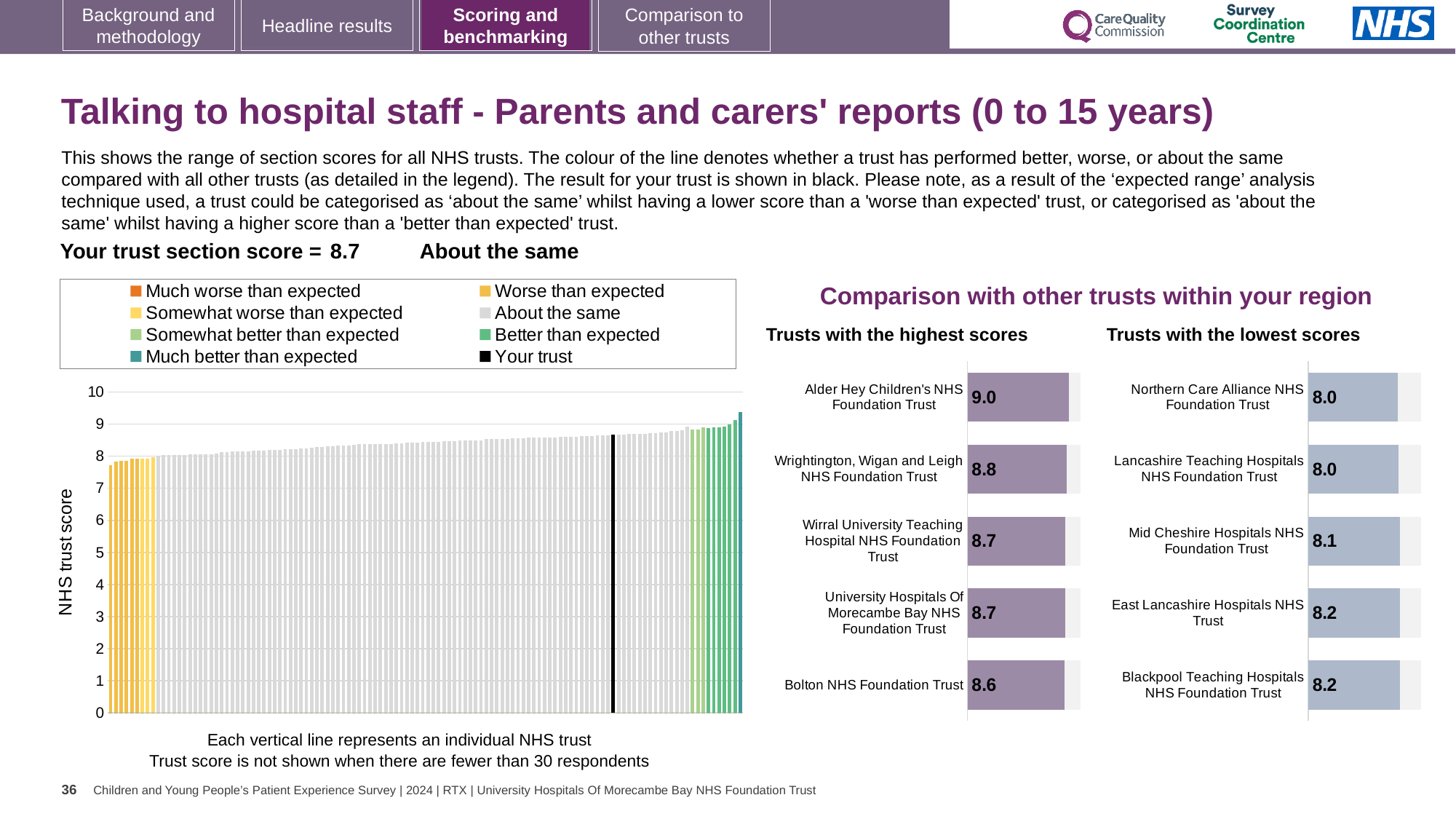
In the 'Trusts with the highest scores' chart, what is the score for Alder Hey Children's NHS Foundation Trust? 9.0 In the 'Trusts with the highest scores' chart, which trust has the highest score? Alder Hey Children's NHS Foundation Trust In the large chart on the left showing the range of section scores, is the value for 'Your trust' (the black bar) greater or less than 8? greater In the 'Trusts with the lowest scores' chart, what is the score for Blackpool Teaching Hospitals NHS Foundation Trust? 8.2 In the 'Trusts with the highest scores' chart, what is the score for Bolton NHS Foundation Trust? 8.6 How many trusts are listed in the 'Trusts with the highest scores' chart? 5 In the 'Trusts with the lowest scores' chart, what is the difference between the scores of East Lancashire Hospitals NHS Trust and Northern Care Alliance NHS Foundation Trust? 0.2 In the 'Trusts with the lowest scores' chart, which has the larger score: Mid Cheshire Hospitals NHS Foundation Trust or Lancashire Teaching Hospitals NHS Foundation Trust? Mid Cheshire Hospitals NHS Foundation Trust In the 'Trusts with the lowest scores' chart, what is the score for Mid Cheshire Hospitals NHS Foundation Trust? 8.1 How many entries does the legend of the large chart on the left list? 8 What kind of chart is the large chart on the left showing the range of section scores? Bar chart In the 'Trusts with the highest scores' chart, what is the difference between the scores of Alder Hey Children's NHS Foundation Trust and Bolton NHS Foundation Trust? 0.4